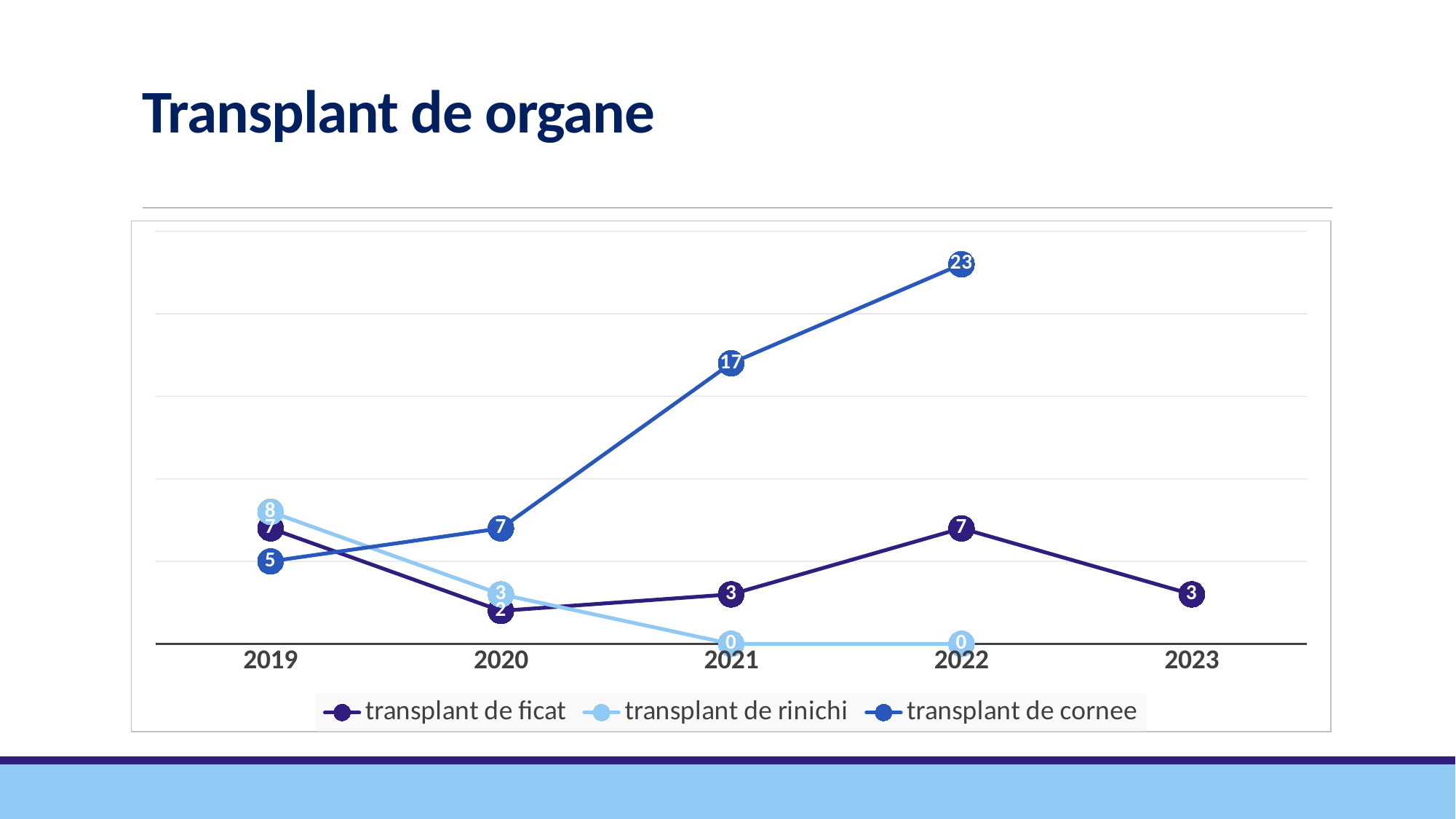
What is the value for transplant de ficat in 2020? 2 In which year is transplant de ficat lowest? 2020 What type of chart is shown on the slide? line chart In which year is transplant de cornee highest? 2022 Which is larger in 2019, transplant de rinichi or transplant de cornee? transplant de rinichi What is the difference between transplant de cornee in 2022 and in 2021? 6 Does transplant de cornee rise or fall from 2019 to 2022? rise What is the title of the slide? Transplant de organe What is the value for transplant de rinichi in 2019? 8 What is the value for transplant de cornee in 2022? 23 How many series does the legend list? 3 What is the value for transplant de ficat in 2023? 3